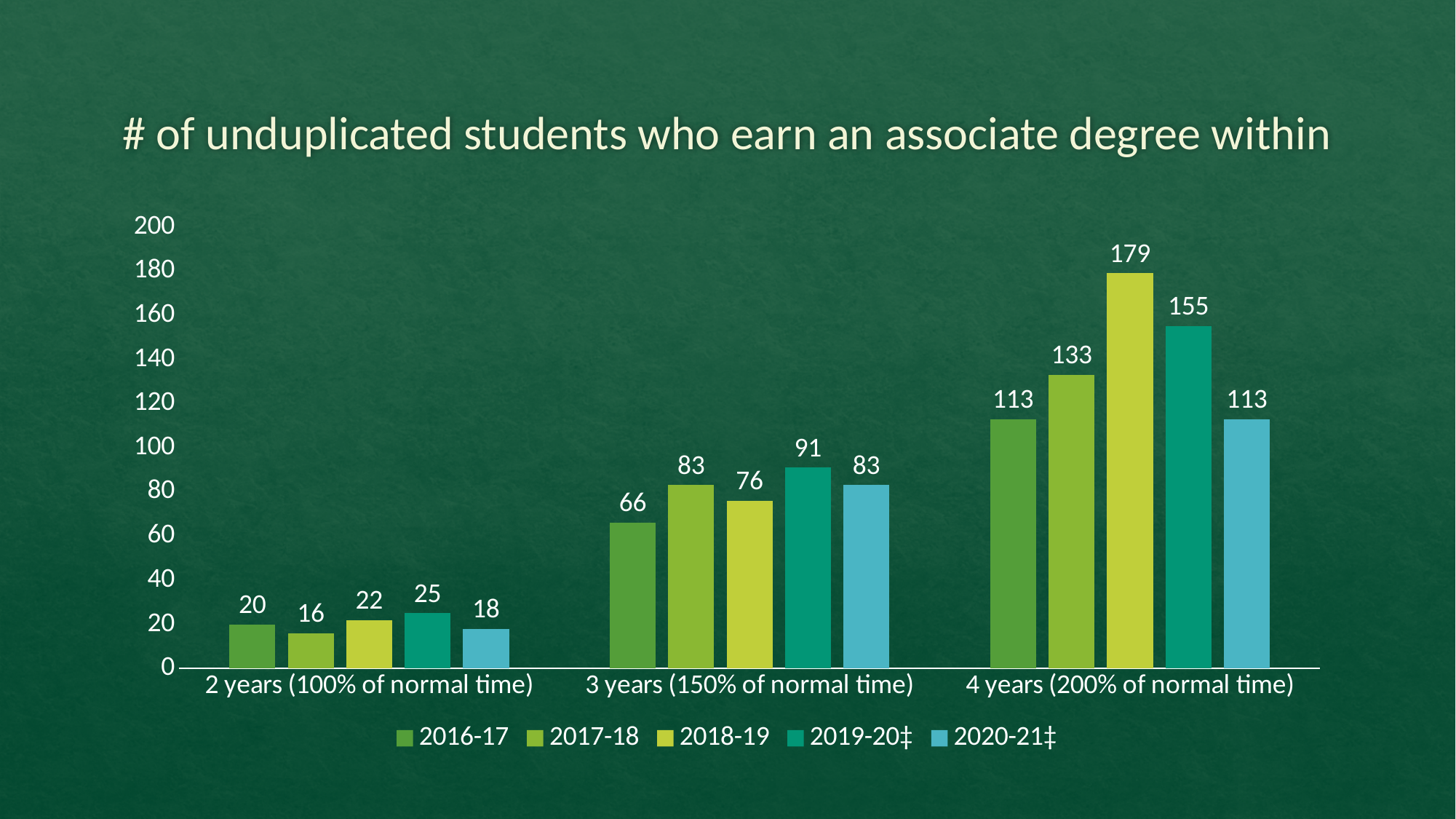
What is the value for 2016-17 in the 3 years (150% of normal time) category? 66 What is the title of the chart? # of unduplicated students who earn an associate degree within Which series has the lowest value in the 2 years (100% of normal time) category? 2017-18 Which is larger in the 3 years (150% of normal time) category: 2017-18 or 2018-19? 2017-18 What is the difference between the 2018-19 and 2019-20‡ values in the 4 years (200% of normal time) category? 24 What is the value for 2019-20‡ in the 2 years (100% of normal time) category? 25 How many categories are shown on the x axis? 3 How many series does the legend list? 5 What kind of chart is shown on the slide? Bar chart Is the value for 2019-20‡ in the 4 years (200% of normal time) category greater or less than 140? greater What is the value for 2018-19 in the 4 years (200% of normal time) category? 179 Which series has the highest value in the 4 years (200% of normal time) category? 2018-19